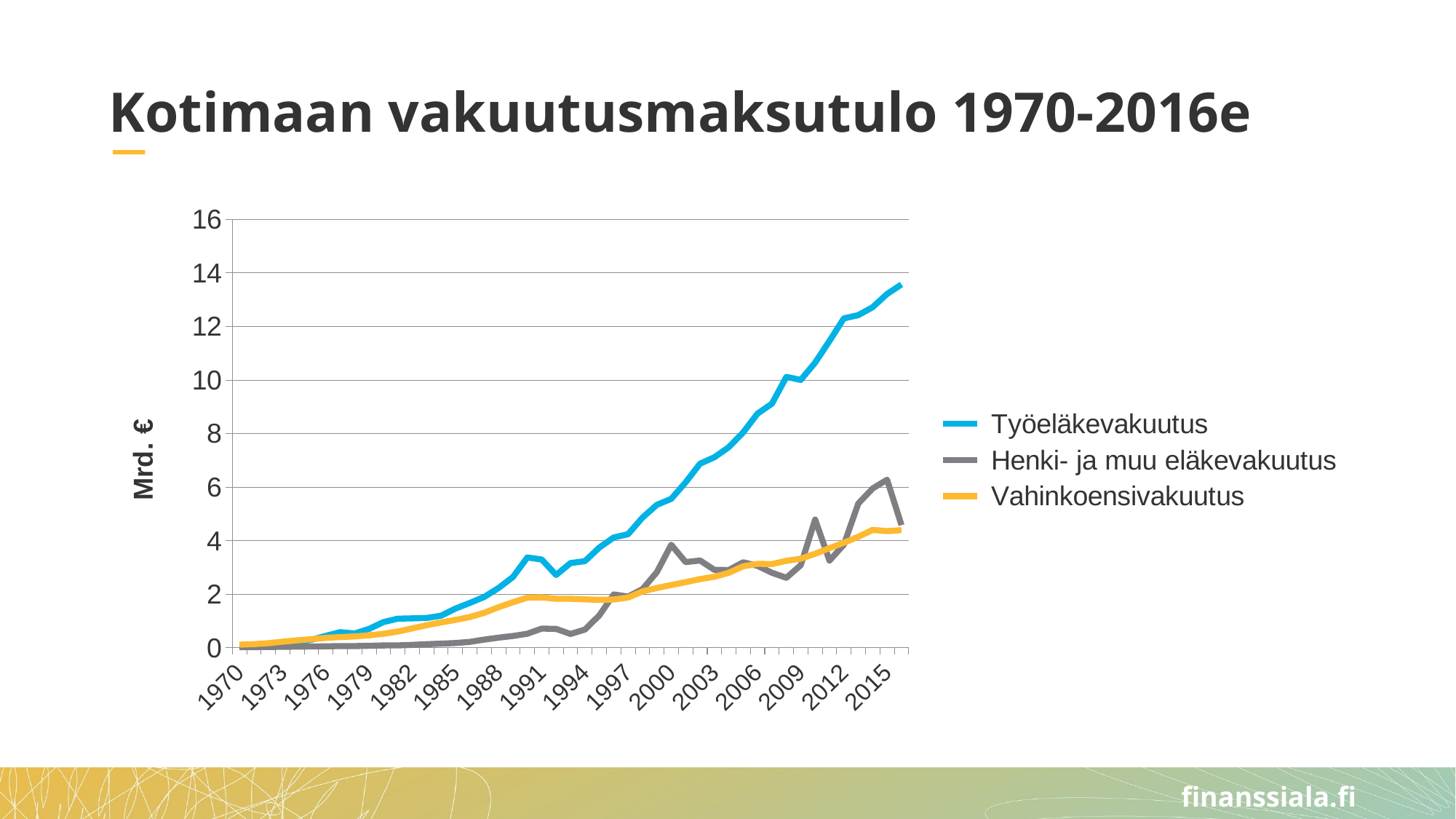
Which series has the highest value at the end of the period (2015)? Työeläkevakuutus What is the title of the chart? Kotimaan vakuutusmaksutulo 1970-2016e Which series has the lowest value in 1991? Henki- ja muu eläkevakuutus Is the value for Vahinkoensivakuutus in 2015 greater or less than 6? less Is the value for Työeläkevakuutus in 1991 greater or less than 4? less Does the Työeläkevakuutus series generally rise or fall from 1970 to 2015? rise Is the value for Työeläkevakuutus in 2015 greater or less than 12? greater What kind of chart is shown on the slide? line chart How many series does the legend list? 3 In 2015, which is larger: Työeläkevakuutus or Vahinkoensivakuutus? Työeläkevakuutus What is the label on the vertical axis? Mrd. €